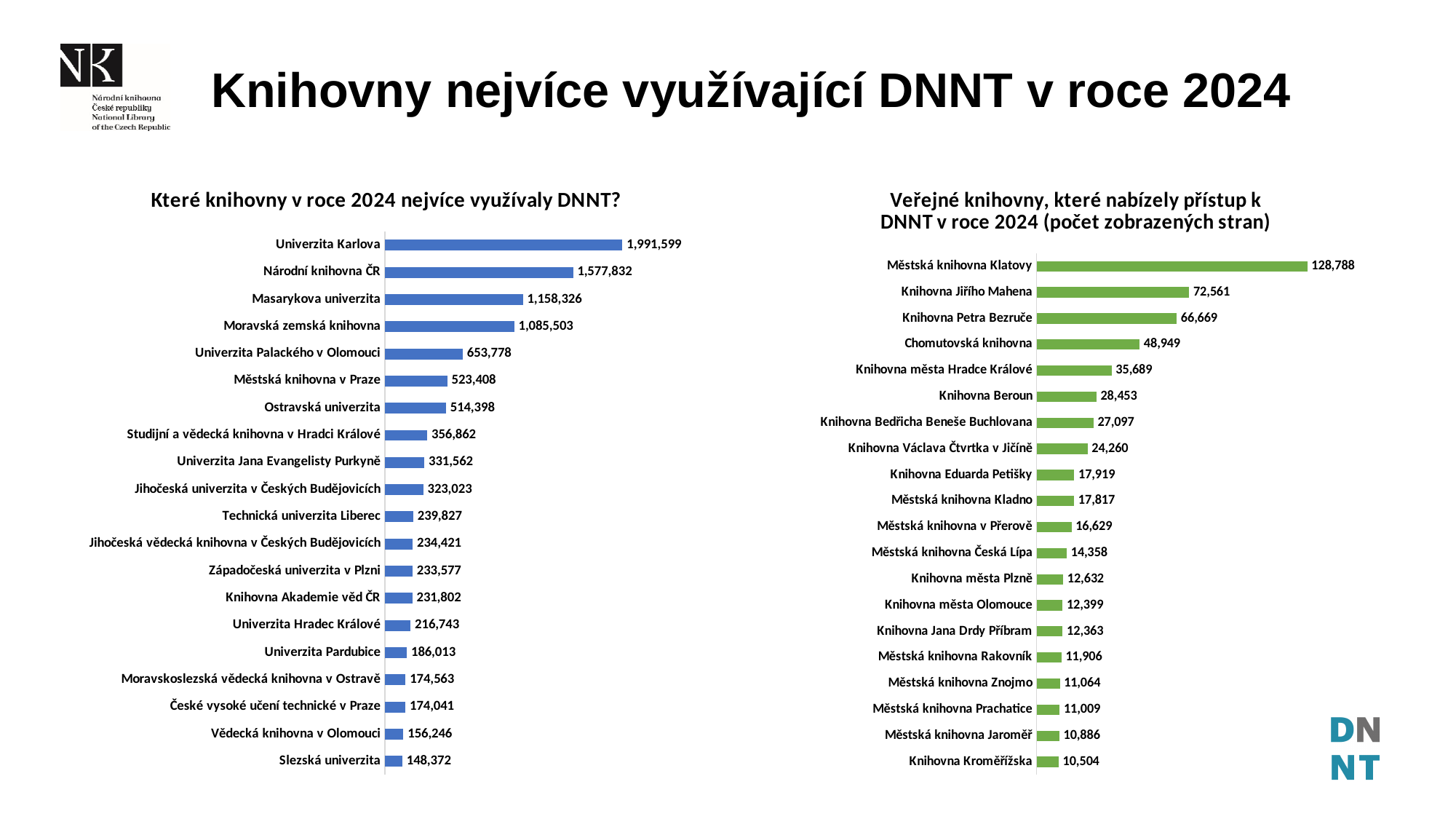
What type of chart is the right chart 'Veřejné knihovny, které nabízely přístup k DNNT v roce 2024'? Bar chart In the right chart 'Veřejné knihovny, které nabízely přístup k DNNT v roce 2024', what is the value for Knihovna Beroun? 28,453 In the right chart 'Veřejné knihovny, které nabízely přístup k DNNT v roce 2024', which library has the highest value? Městská knihovna Klatovy How many libraries are listed in the left chart 'Které knihovny v roce 2024 nejvíce využívaly DNNT?'? 20 In the right chart 'Veřejné knihovny, které nabízely přístup k DNNT v roce 2024', what is the value for Knihovna Kroměřížska? 10,504 In the left chart 'Které knihovny v roce 2024 nejvíce využívaly DNNT?', what is the value for Moravská zemská knihovna? 1,085,503 What colour are the bars in the left chart 'Které knihovny v roce 2024 nejvíce využívaly DNNT?'? Blue In the left chart 'Které knihovny v roce 2024 nejvíce využívaly DNNT?', what is the difference between Univerzita Karlova and Národní knihovna ČR? 413,767 In the right chart 'Veřejné knihovny, které nabízely přístup k DNNT v roce 2024', what is the difference between Městská knihovna Klatovy and Knihovna Jiřího Mahena? 56,227 In the left chart 'Které knihovny v roce 2024 nejvíce využívaly DNNT?', which library has the lowest value? Slezská univerzita In the left chart 'Které knihovny v roce 2024 nejvíce využívaly DNNT?', what is the value for Univerzita Karlova? 1,991,599 In the left chart 'Které knihovny v roce 2024 nejvíce využívaly DNNT?', which is larger: Univerzita Palackého v Olomouci or Městská knihovna v Praze? Univerzita Palackého v Olomouci